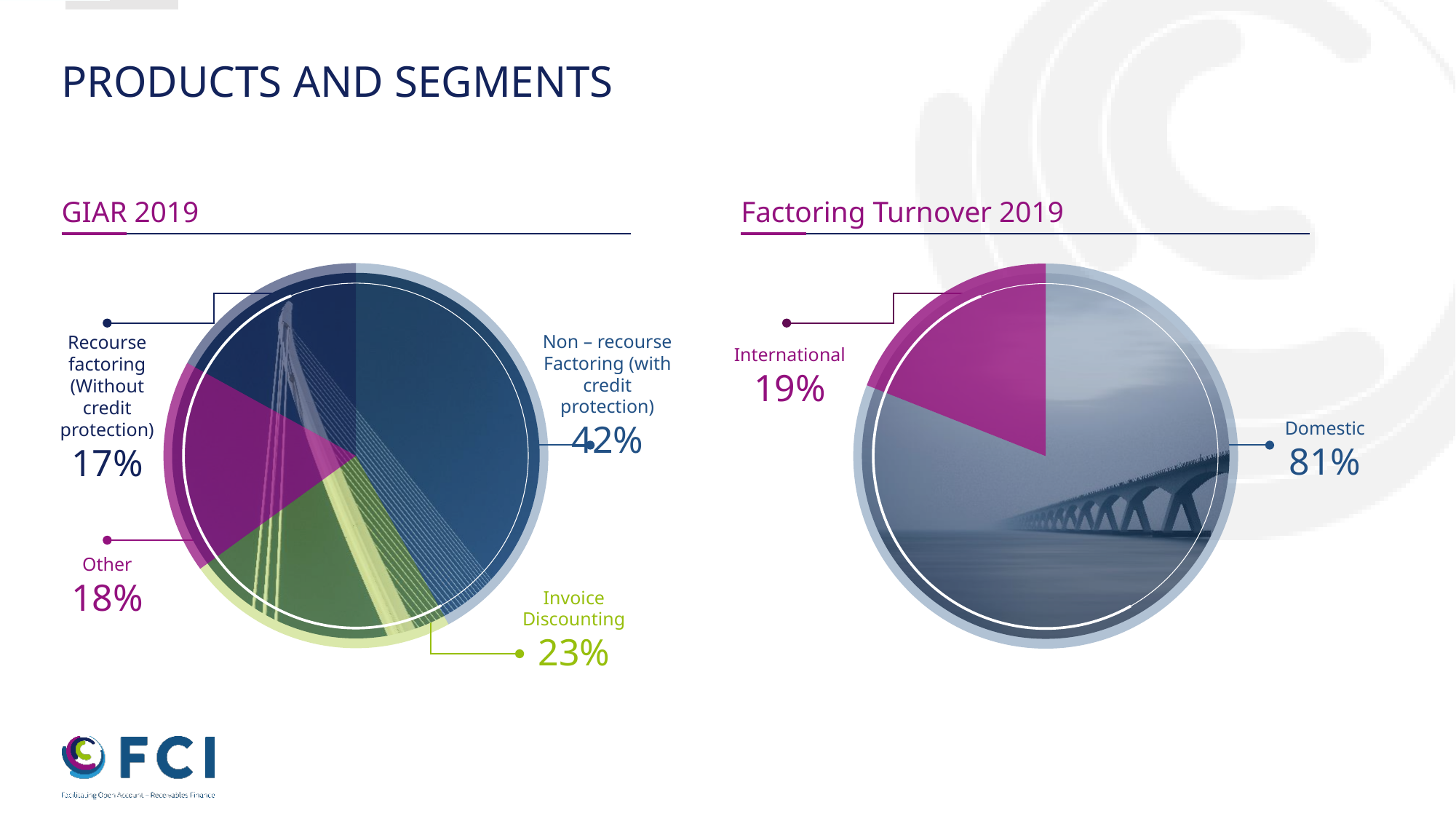
In the Factoring Turnover 2019 chart, which is larger, Domestic or International? Domestic In the Factoring Turnover 2019 chart, what share is Domestic? 81% In the GIAR 2019 chart, what share is Invoice Discounting? 23% In the GIAR 2019 chart, which segment has the largest share? Non – recourse Factoring (with credit protection) In the GIAR 2019 chart, what share is Recourse factoring (Without credit protection)? 17% In the Factoring Turnover 2019 chart, what is the difference in percentage points between Domestic and International? 62 In the GIAR 2019 chart, how many segments does the pie have? 4 In the GIAR 2019 chart, what share is Non – recourse Factoring (with credit protection)? 42% In the Factoring Turnover 2019 chart, what share is International? 19% In the GIAR 2019 chart, which segment has the smallest share? Recourse factoring (Without credit protection) In the GIAR 2019 chart, what is the difference in percentage points between Non – recourse Factoring and Invoice Discounting? 19 What kind of chart is the GIAR 2019 chart? Pie chart